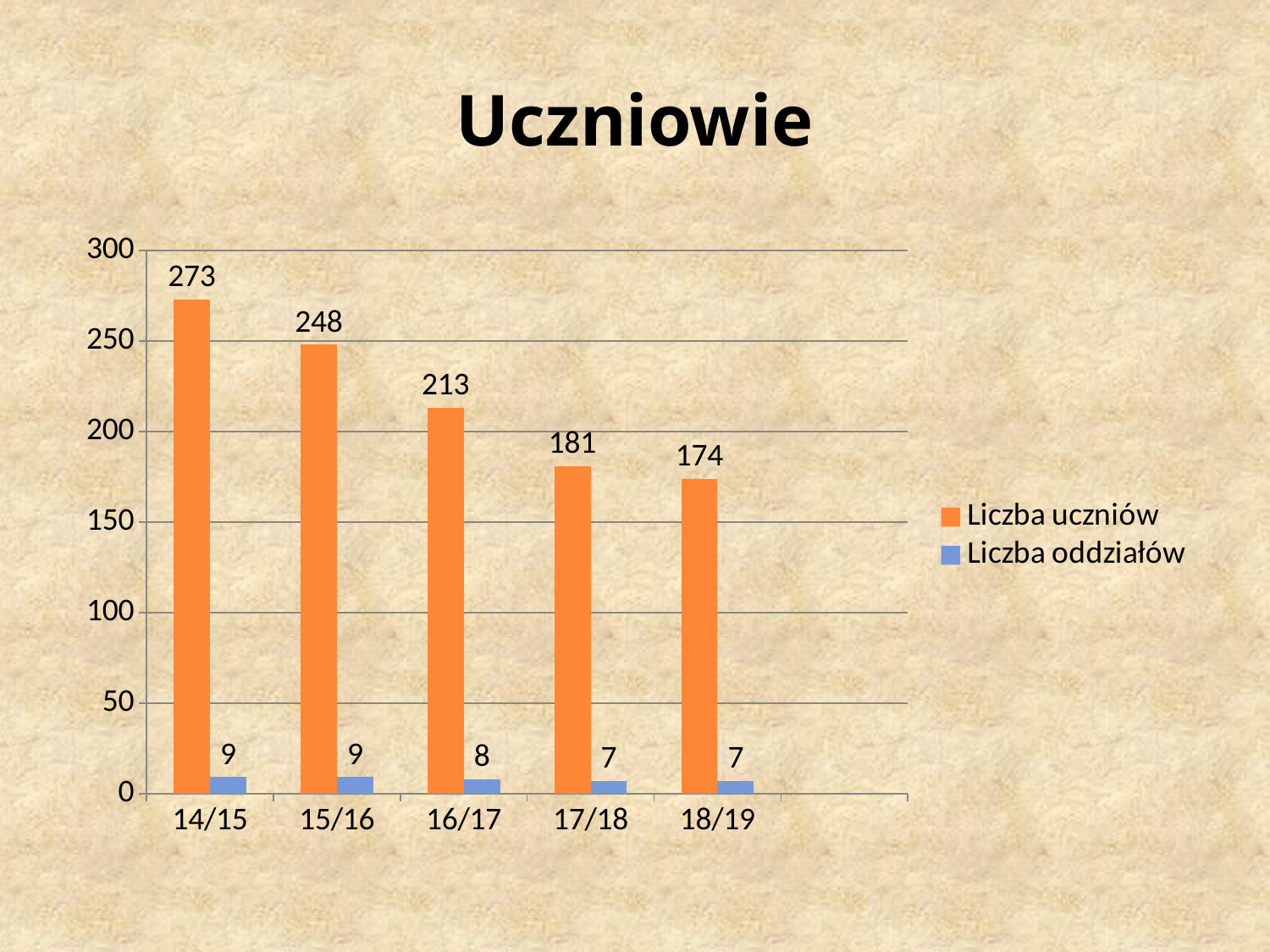
Which is larger, Liczba uczniów in 16/17 or in 17/18? 16/17 What is the value of Liczba uczniów for 14/15? 273 What is the difference between Liczba uczniów in 14/15 and 15/16? 25 How many years are shown on the x axis? 5 What is the difference between Liczba uczniów in 17/18 and 18/19? 7 What kind of chart is shown on the slide? bar chart What is the value of Liczba uczniów for 18/19? 174 What is the value of Liczba oddziałów for 16/17? 8 Which year has the lowest value for Liczba uczniów? 18/19 How many series does the legend list? 2 Is the value of Liczba uczniów for 16/17 greater or less than 200? greater Which year has the highest value for Liczba uczniów? 14/15